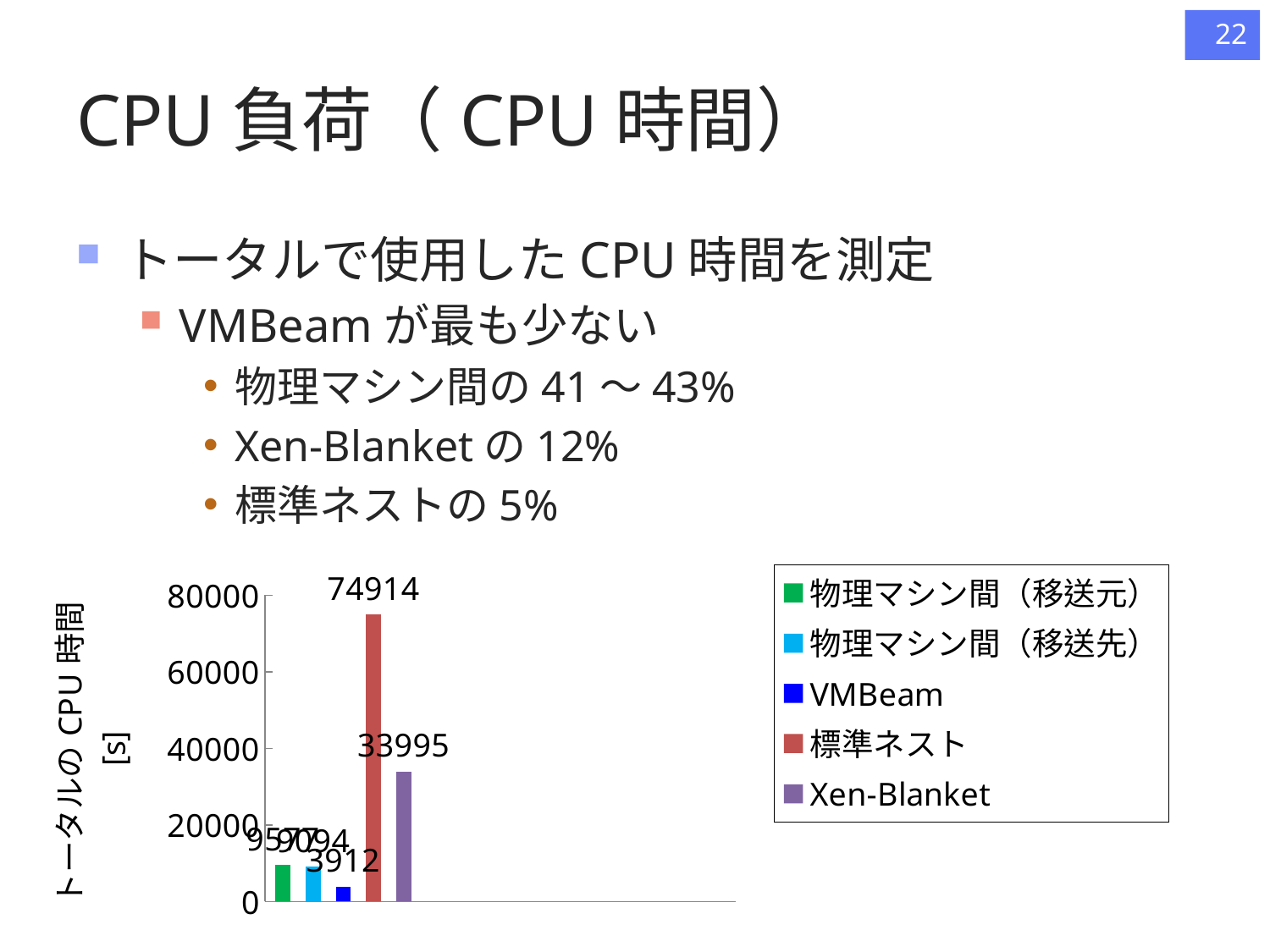
What is the difference between the values for 標準ネスト and Xen-Blanket? 40919 How many series does the chart legend list? 5 What type of chart is shown on the slide? bar chart What is the value for VMBeam in the chart? 3912 Which is larger, the value for Xen-Blanket or the value for VMBeam? Xen-Blanket What is the label of the vertical axis of the chart? トータルの CPU 時間 [s] Is the value for 物理マシン間（移送元） greater or less than 20000? less What is the value for Xen-Blanket in the chart? 33995 Which series has the lowest value in the chart? VMBeam What is the difference between the values for Xen-Blanket and VMBeam? 30082 What is the value for 標準ネスト in the chart? 74914 Which series has the highest value in the chart? 標準ネスト